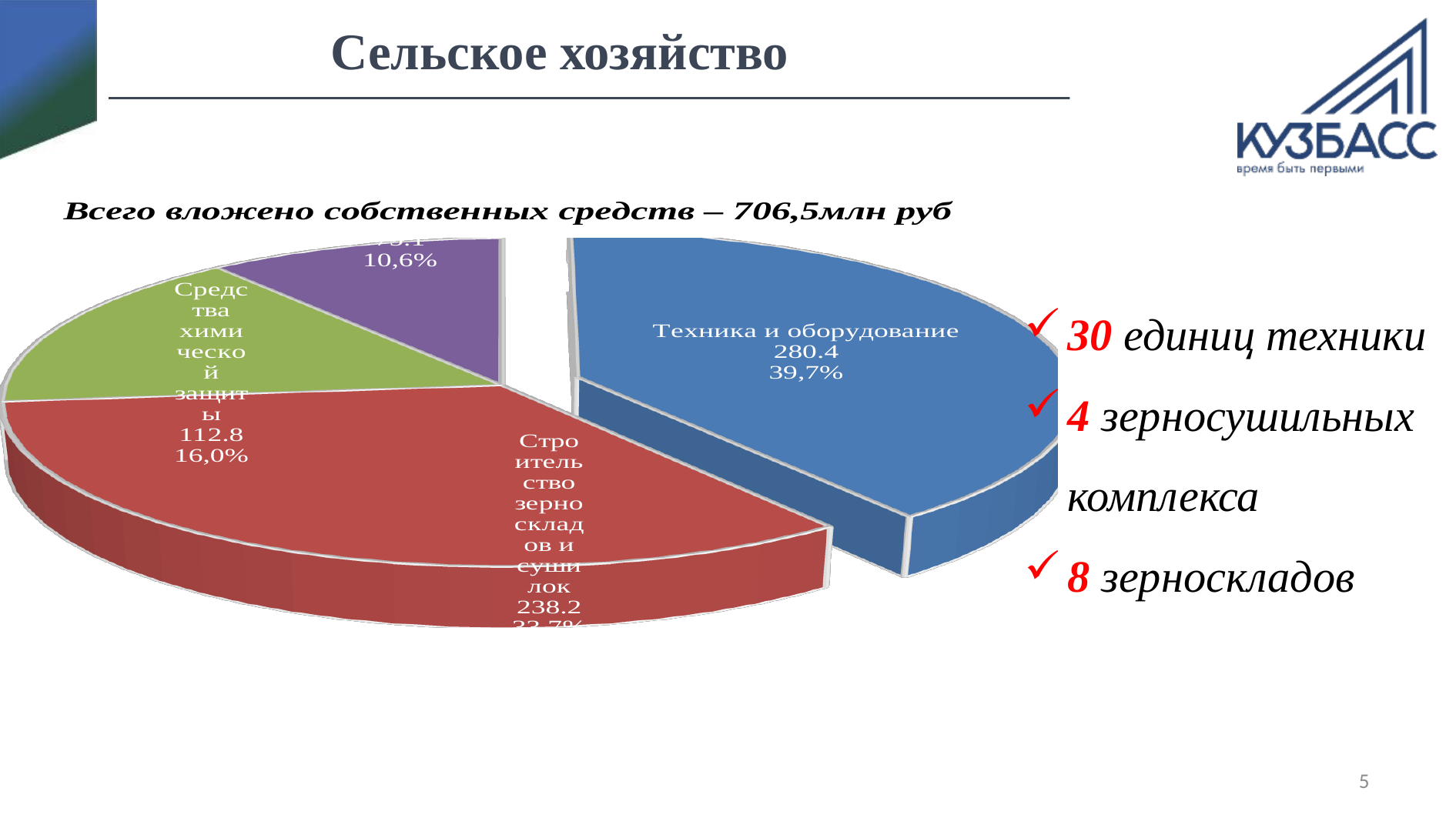
What is the difference between the values for "Техника и оборудование" and "Строительство зерноскладов и сушилок"? 42.2 What percentage is shown on the smallest slice of the pie chart? 10,6% What share of the pie does "Техника и оборудование" represent? 39,7% What share of the pie does "Средства химической защиты" represent? 16,0% What colour is the "Техника и оборудование" slice? blue What value is shown for the slice "Строительство зерноскладов и сушилок"? 238.2 What type of chart is shown on the slide? pie chart What value is shown for the slice "Средства химической защиты"? 112.8 How many slices does the pie chart have? 4 Which is larger: "Техника и оборудование" or "Строительство зерноскладов и сушилок"? Техника и оборудование Which slice of the pie chart is the largest? Техника и оборудование What value is shown for the slice "Техника и оборудование"? 280.4